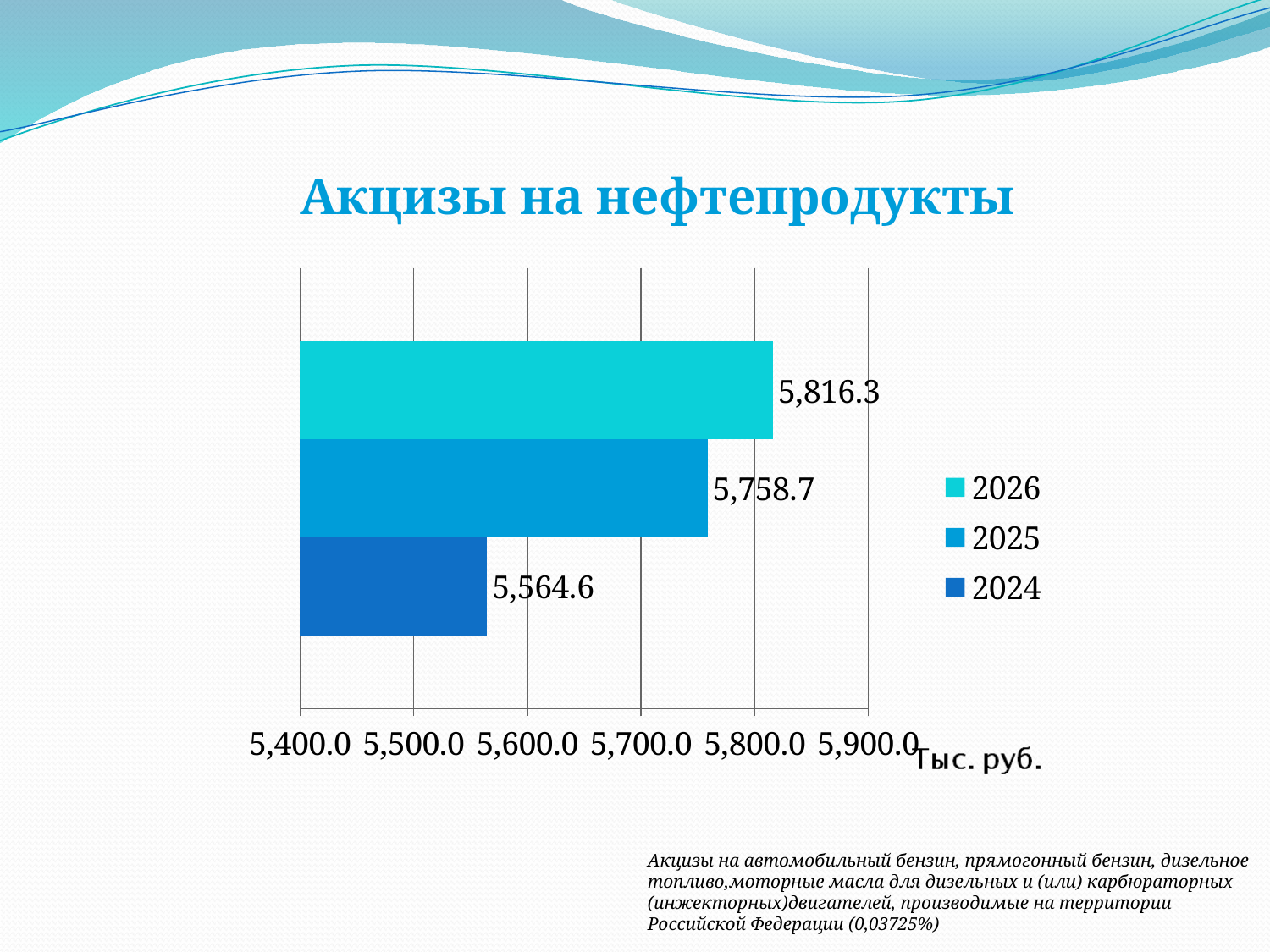
What kind of chart is shown on the slide? bar chart Which year has the lowest value? 2024 What is the title of the chart? Акцизы на нефтепродукты What is the difference between the values for 2026 and 2025? 57.6 How many series does the legend list? 3 Is the value for 2024 greater or less than 5,600.0? less What is the value for 2025? 5,758.7 What is the value for 2026? 5,816.3 Which is larger, the value for 2025 or the value for 2024? 2025 What is the difference between the values for 2025 and 2024? 194.1 Which year has the highest value? 2026 What is the value for 2024? 5,564.6